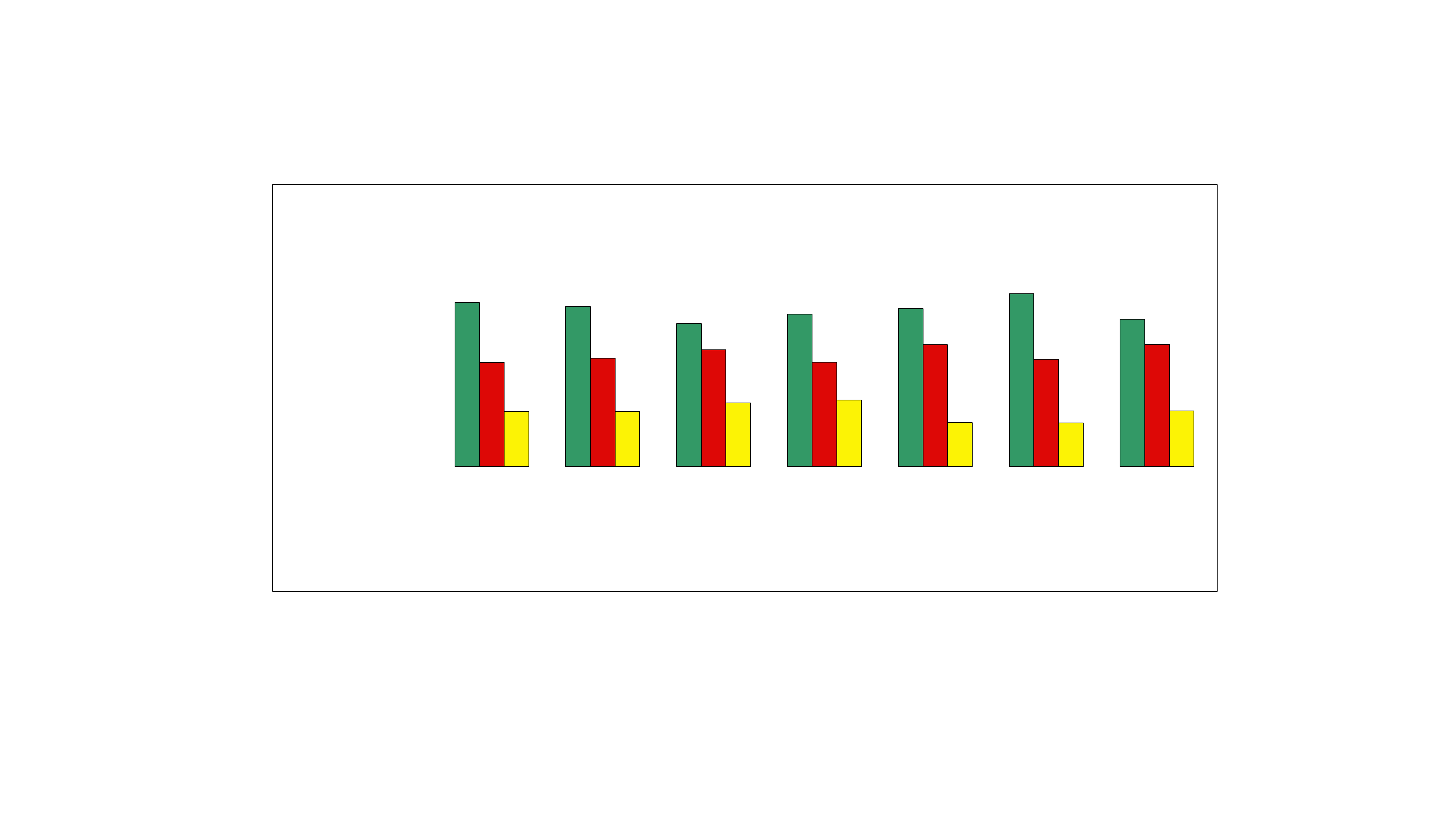
How many groups of bars does the chart contain? 7 In the first group from the left, is the green bar or the red bar taller? green What kind of chart is shown on the slide? bar chart Does the chart show any axis labels, data labels or a legend? no Which colour bar is the shortest in every group? yellow Which group (counting from the left) has the tallest green bar? the sixth group Which colour bar is the tallest in every group? green How many bars are in each group of the chart? 3 What colours are the three bars in each group, from left to right? green, red, yellow